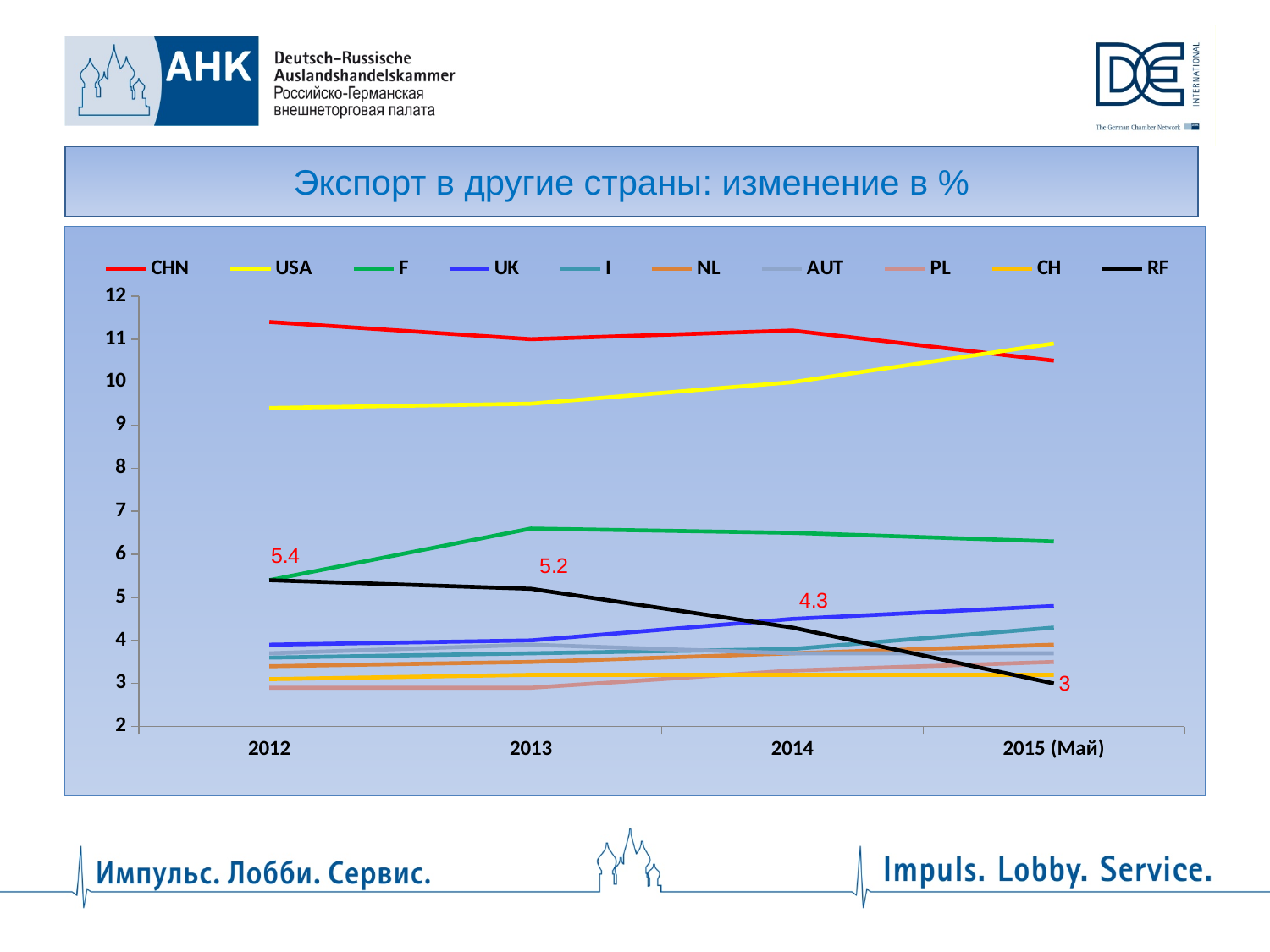
How many series does the legend list? 10 Is the value for USA in 2012 greater or less than 10? less Does the RF line rise or fall from 2012 to 2015 (Май)? fall How many points are there along the x axis? 4 Is the value for CHN in 2012 greater or less than 11? greater Which series has the highest value in 2012? CHN By how much did the value for RF fall from 2012 to 2015 (Май)? 2.4 What is the value for RF in 2015 (Май)? 3 What kind of chart is shown on the slide? line chart What is the value for RF in 2014? 4.3 What is the title of the chart? Экспорт в другие страны: изменение в % What is the value for RF in 2012? 5.4